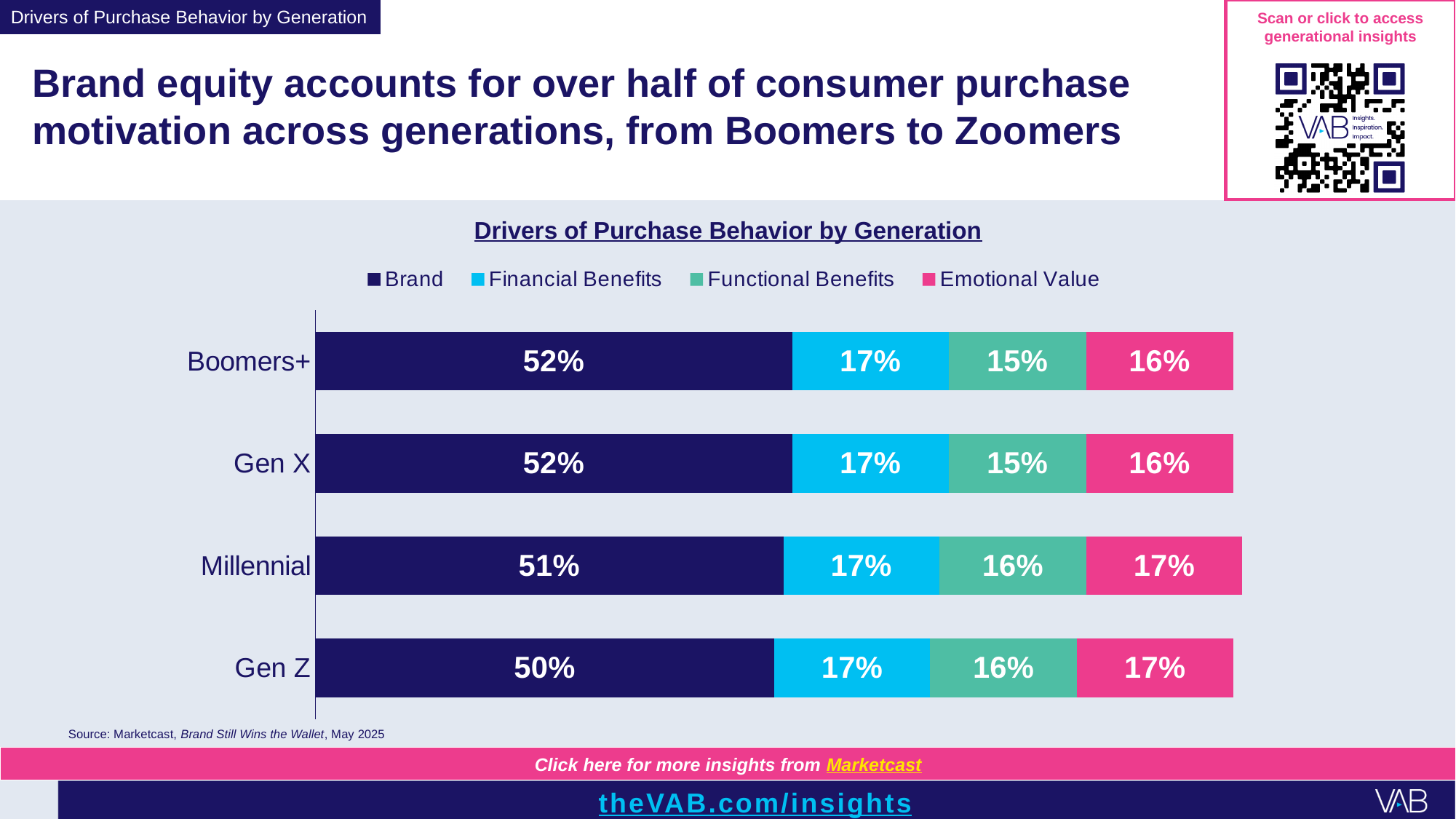
What is the Brand value for Gen Z? 50% What type of chart is shown on the slide? Stacked bar chart How many generation categories are shown in the chart? 4 What is the title of the chart? Drivers of Purchase Behavior by Generation Which segment is the largest in the Gen Z bar? Brand What is the Functional Benefits value for Boomers+? 15% Is the Brand value for Boomers+ larger or smaller than the Brand value for Millennial? Larger What is the difference between the Brand value for Boomers+ and the Brand value for Gen Z? 2% Which generation has the lowest Brand value? Gen Z What is the Emotional Value share for Millennial? 17% How many series does the legend list? 4 What is the Financial Benefits value for Gen X? 17%